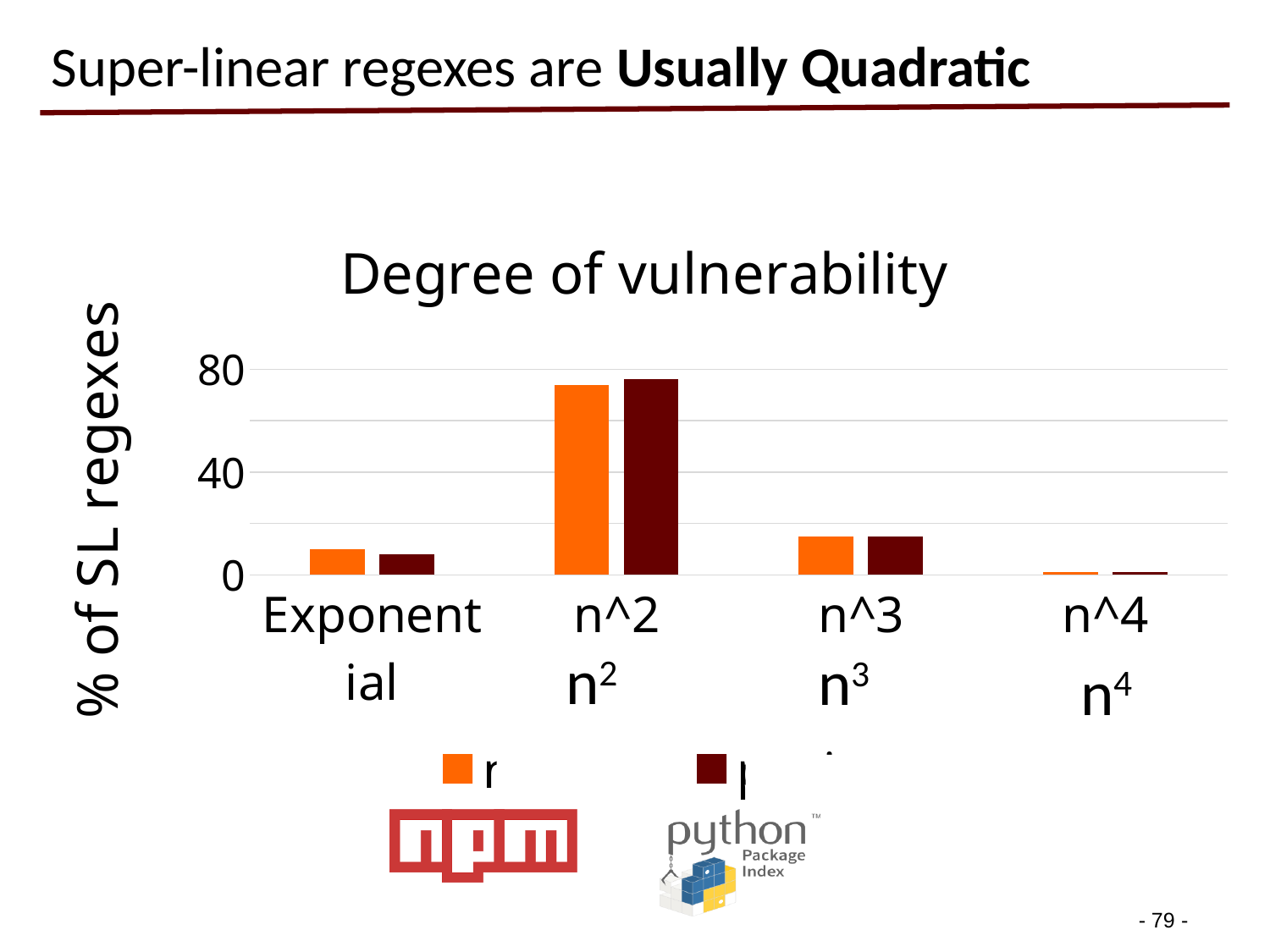
What is the title of the chart? Degree of vulnerability Is the orange bar for n^2 greater or less than 40? greater Is the dark red bar for Exponential greater or less than 40? less Is the orange bar for n^3 greater or less than 40? less For the orange series, which is larger: the value for n^2 or the value for n^3? n^2 Which category has the highest value for the dark red series? n^2 How many series does the chart's legend list? 2 What kind of chart is shown on the slide? bar chart How many categories are shown along the x axis of the chart? 4 What is the label on the vertical axis of the chart? % of SL regexes Which category has the highest value for the orange series? n^2 Which category has the lowest value for the orange series? n^4